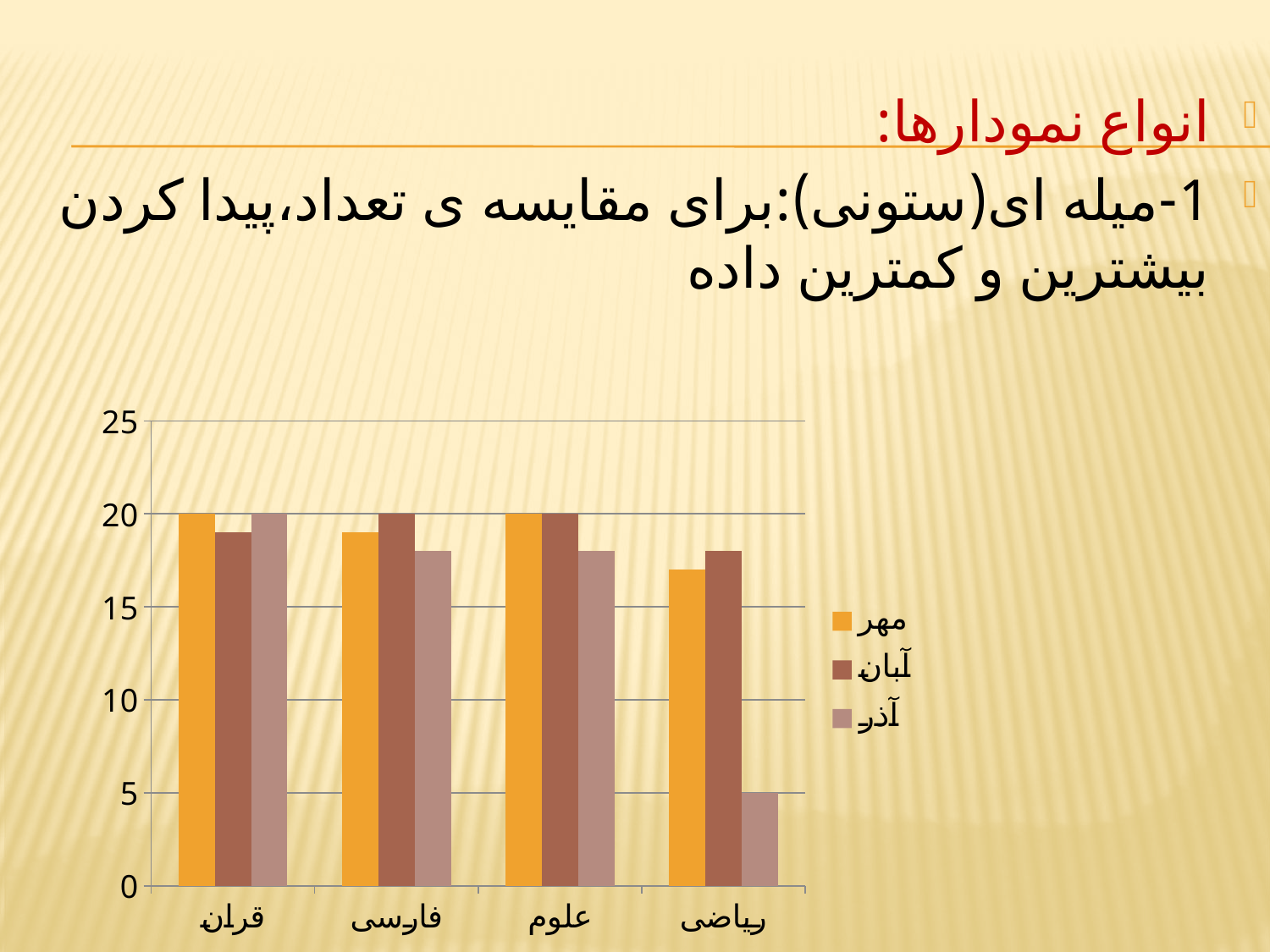
What kind of chart is shown on the slide? bar chart Which is larger, the مهر value for قرآن or the مهر value for ریاضی? قرآن For ریاضی, which is larger, the آبان value or the آذر value? آبان Is the value of مهر for ریاضی greater or less than 15? greater What is the value of مهر for قرآن? 20 Is the value of آذر for ریاضی greater or less than 10? less What are the three series listed in the chart's legend? مهر, آبان, آذر How many series does the chart's legend list? 3 How many categories are shown on the x axis of the chart? 4 What is the difference between the مهر value for قرآن and the آذر value for ریاضی? 15 Which category has the lowest آذر value? ریاضی What is the value of آذر for ریاضی? 5